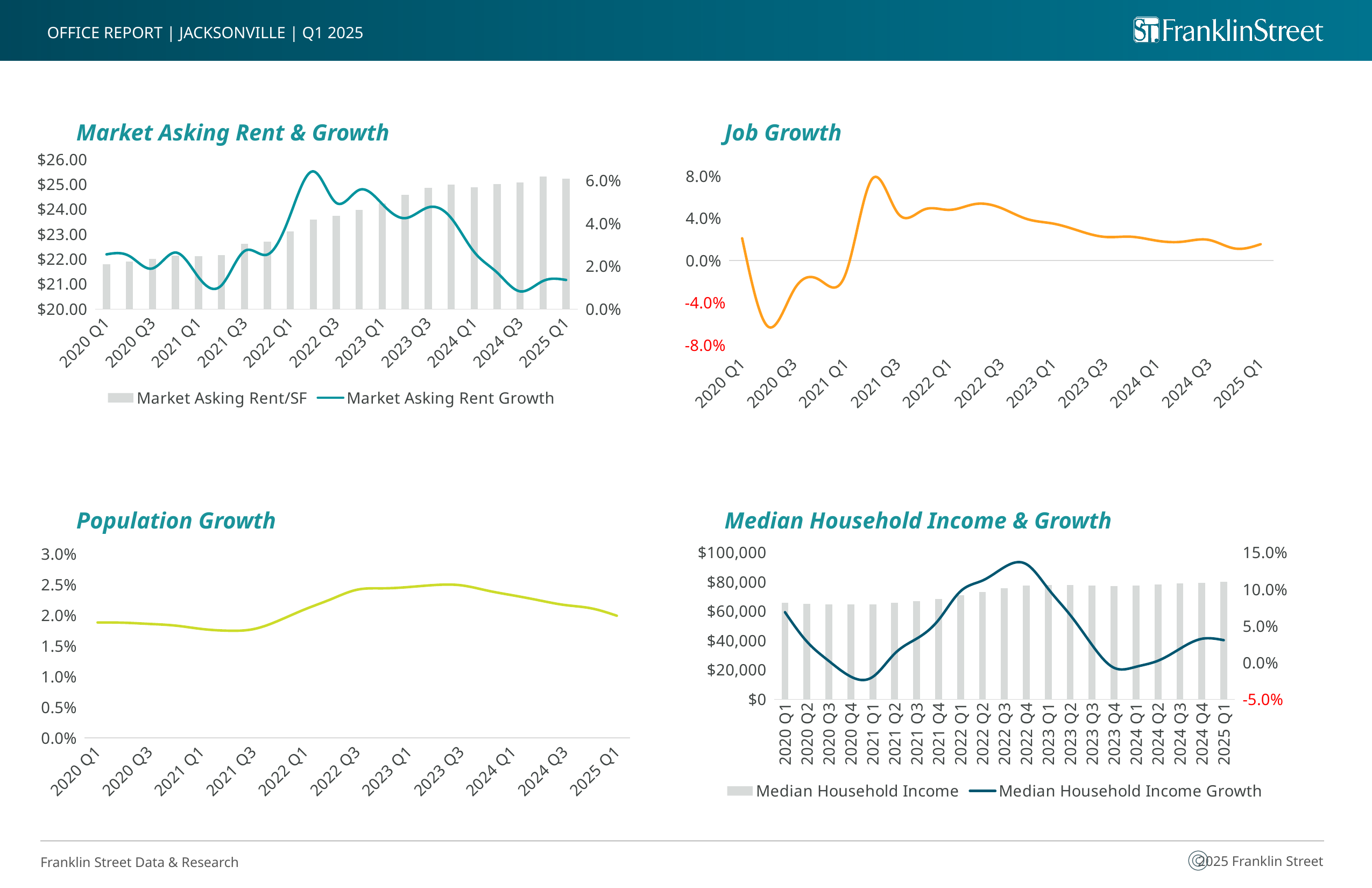
In the Market Asking Rent & Growth chart, is the Market Asking Rent/SF value for 2023 Q1 greater or less than $23.00? greater In the Median Household Income & Growth chart, is the Median Household Income Growth value for 2022 Q4 greater or less than 10.0%? greater What kind of chart is the Job Growth chart? line chart In the Population Growth chart, does the line rise or fall from 2023 Q3 to 2025 Q1? fall In the Job Growth chart, is the peak value in 2021 greater or less than 4.0%? greater What colour is the line in the Job Growth chart? orange How many series does the legend of the Market Asking Rent & Growth chart list? 2 In the Market Asking Rent & Growth chart, do the Market Asking Rent/SF bars generally rise or fall from 2020 Q1 to 2025 Q1? rise In the Job Growth chart, which quarter has the lowest job growth? 2020 Q2 How many bars are plotted in the Median Household Income & Growth chart? 21